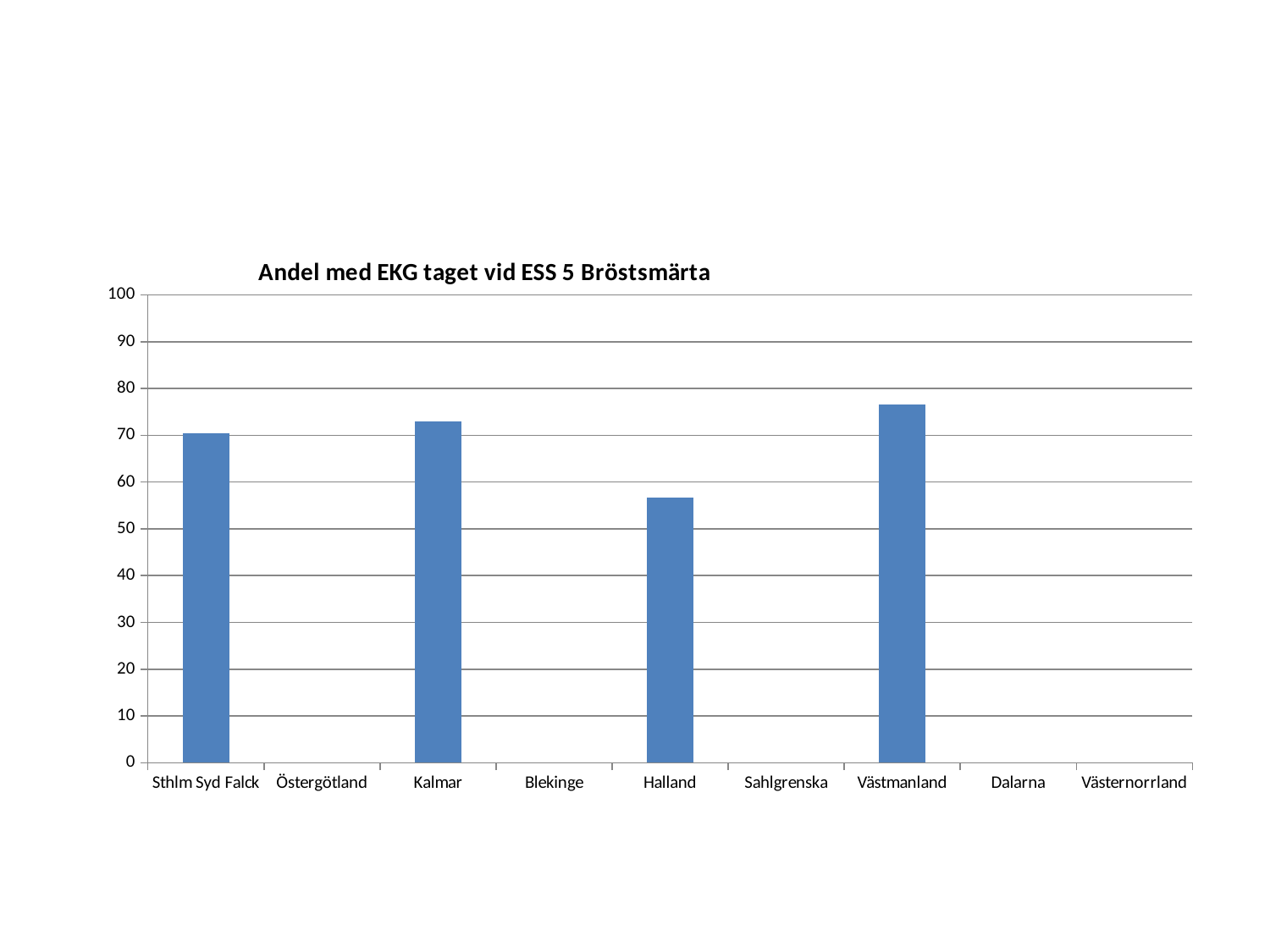
Is the value for Sthlm Syd Falck greater or less than 60? greater How many categories are labelled on the x axis of the chart? 9 What is the maximum value shown on the y axis of the chart? 100 What is the title of the chart? Andel med EKG taget vid ESS 5 Bröstsmärta Which is larger, the value for Halland or the value for Västmanland? Västmanland What kind of chart is shown on the slide? bar chart How many categories have a visible bar in the chart? 4 Which category has the highest bar in the chart? Västmanland Among the categories with a visible bar, which has the lowest value? Halland Is the value for Västmanland greater or less than 70? greater Is the value for Halland greater or less than 60? less